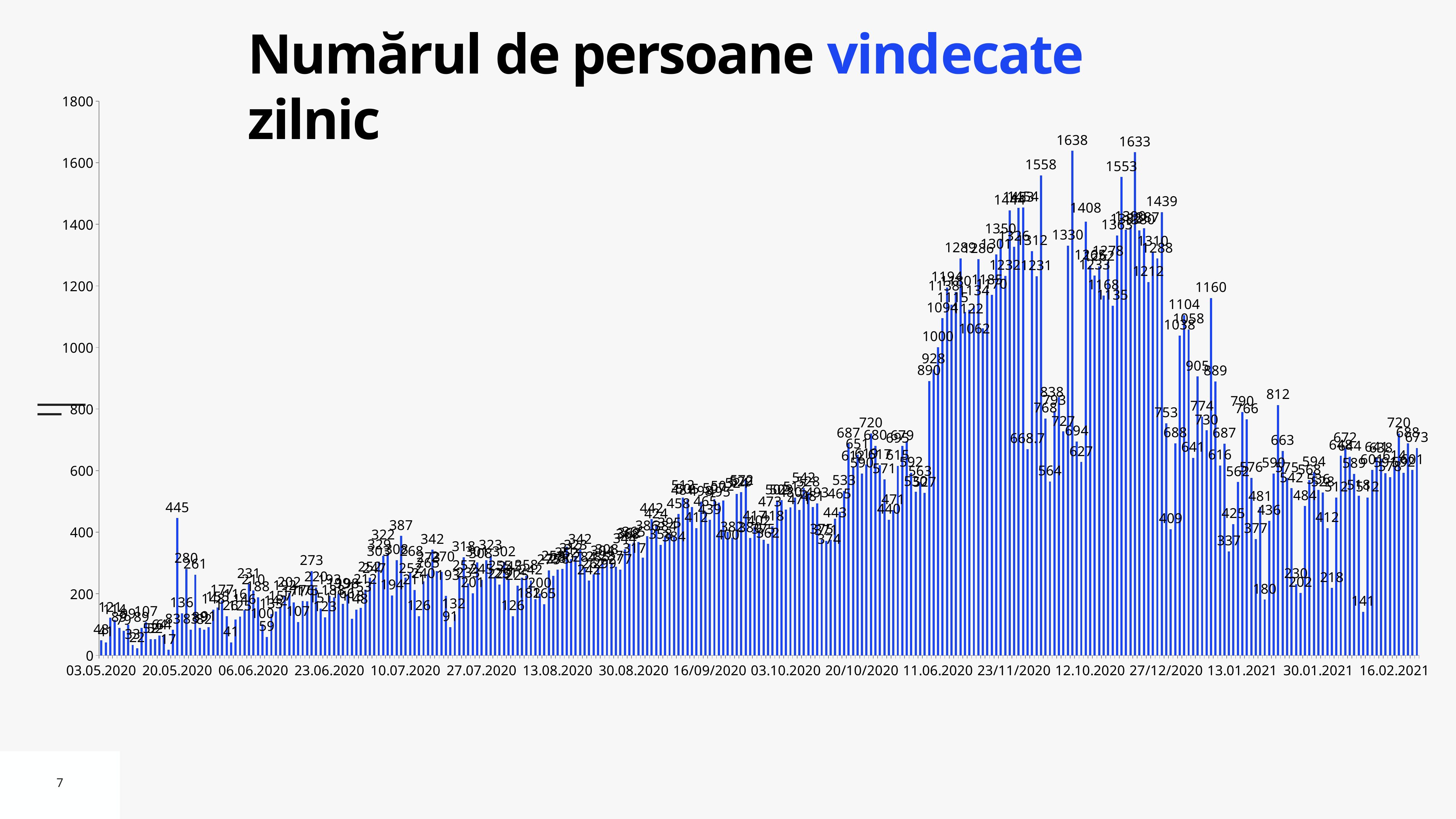
What is the title of the chart? Numărul de persoane vindecate zilnic What kind of chart is shown on the slide? bar chart What is the lowest daily value shown on the chart? 17 Which date has the larger value, 23/11/2020 or 13.01.2021? 23/11/2020 What is the difference between the two tallest bars, labeled 1638 and 1633? 5 Is the value for 23/11/2020 greater or less than 1000? greater What is the difference between the highest value (1638) and the lowest value (17) on the chart? 1621 What is the value for 20.05.2020? 445 Is the value for 16.02.2021 greater or less than 800? less What is the highest daily value shown on the chart? 1638 Is the value for 06.06.2020 greater or less than 400? less